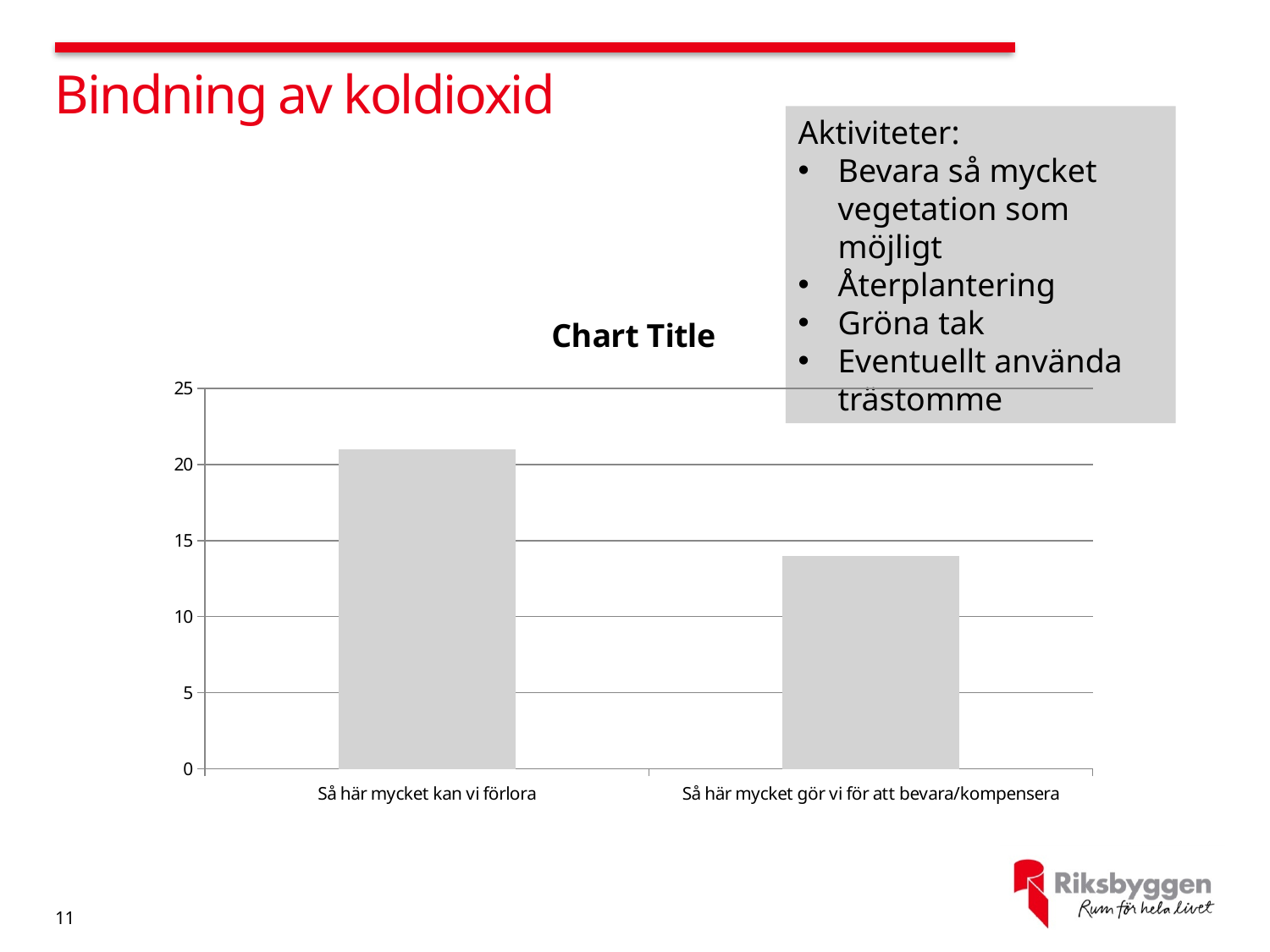
Which category has the lowest bar in the chart? Så här mycket gör vi för att bevara/kompensera How many categories are plotted in the chart? 2 What kind of chart is shown on the slide? bar chart Is the value for 'Så här mycket kan vi förlora' greater or less than 25? less Is the value for 'Så här mycket gör vi för att bevara/kompensera' greater or less than 10? greater Which is larger: the value for 'Så här mycket kan vi förlora' or the value for 'Så här mycket gör vi för att bevara/kompensera'? Så här mycket kan vi förlora What is the highest value shown on the chart's vertical axis? 25 Which category has the highest bar in the chart? Så här mycket kan vi förlora Is the value for 'Så här mycket kan vi förlora' greater or less than 15? greater What is the title shown above the chart? Chart Title Do the bar values rise or fall from left to right along the x axis? fall